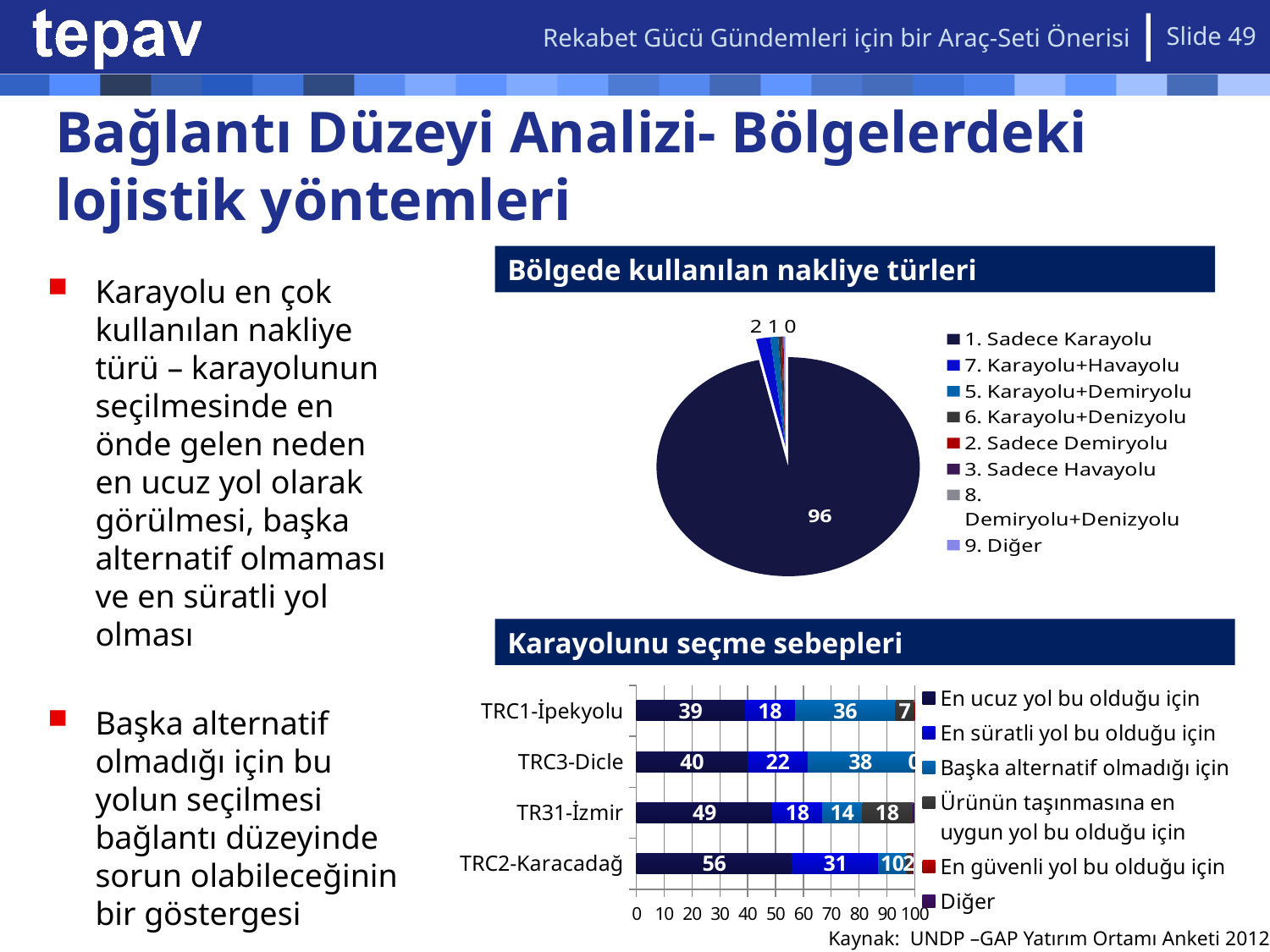
On the 'Karayolunu seçme sebepleri' chart, what is the difference between the 'En ucuz yol bu olduğu için' values for TR31-İzmir and TRC3-Dicle? 9 How many entries does the legend of the 'Bölgede kullanılan nakliye türleri' chart list? 8 On the 'Karayolunu seçme sebepleri' chart, which region has the larger 'En süratli yol bu olduğu için' value, TRC3-Dicle or TRC1-İpekyolu? TRC3-Dicle On the 'Karayolunu seçme sebepleri' chart, which region has the highest 'En ucuz yol bu olduğu için' value? TRC2-Karacadağ On the 'Bölgede kullanılan nakliye türleri' chart, what value is shown for '1. Sadece Karayolu'? 96 How many regions are shown on the 'Karayolunu seçme sebepleri' chart? 4 What kind of chart is 'Karayolunu seçme sebepleri'? Bar chart How many series does the legend of the 'Karayolunu seçme sebepleri' chart list? 6 On the 'Karayolunu seçme sebepleri' chart, what is the 'Başka alternatif olmadığı için' value for TRC3-Dicle? 38 What kind of chart is 'Bölgede kullanılan nakliye türleri'? Pie chart On the 'Bölgede kullanılan nakliye türleri' chart, which category has the largest slice? 1. Sadece Karayolu On the 'Karayolunu seçme sebepleri' chart, what is the 'En ucuz yol bu olduğu için' value for TRC2-Karacadağ? 56